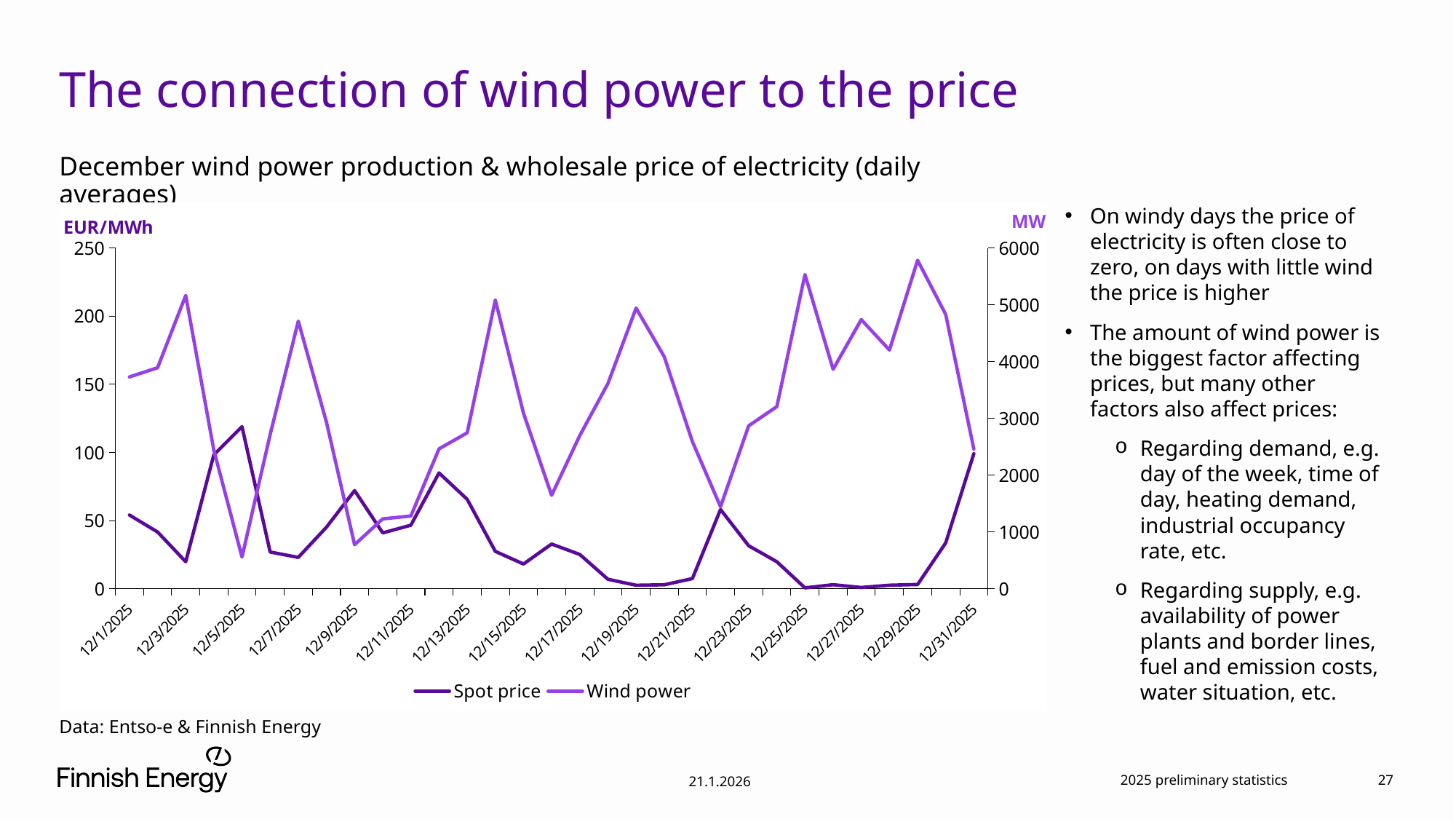
Is the Wind power value on 12/5/2025 greater or less than 1000 MW? less Is the Wind power value on 12/29/2025 greater or less than 5000 MW? greater On which date does the Spot price reach its highest value? 12/5/2025 Is the Spot price on 12/25/2025 greater or less than 50 EUR/MWh? less Which date has the larger Wind power value, 12/5/2025 or 12/7/2025? 12/7/2025 What are the two series named in the chart legend? Spot price and Wind power Does the Spot price rise or fall between 12/25/2025 and 12/31/2025? rise How many date labels are shown on the x axis of the chart? 16 What unit is shown on the left vertical axis of the chart? EUR/MWh What kind of chart is shown on the slide? line chart How many series does the chart legend list? 2